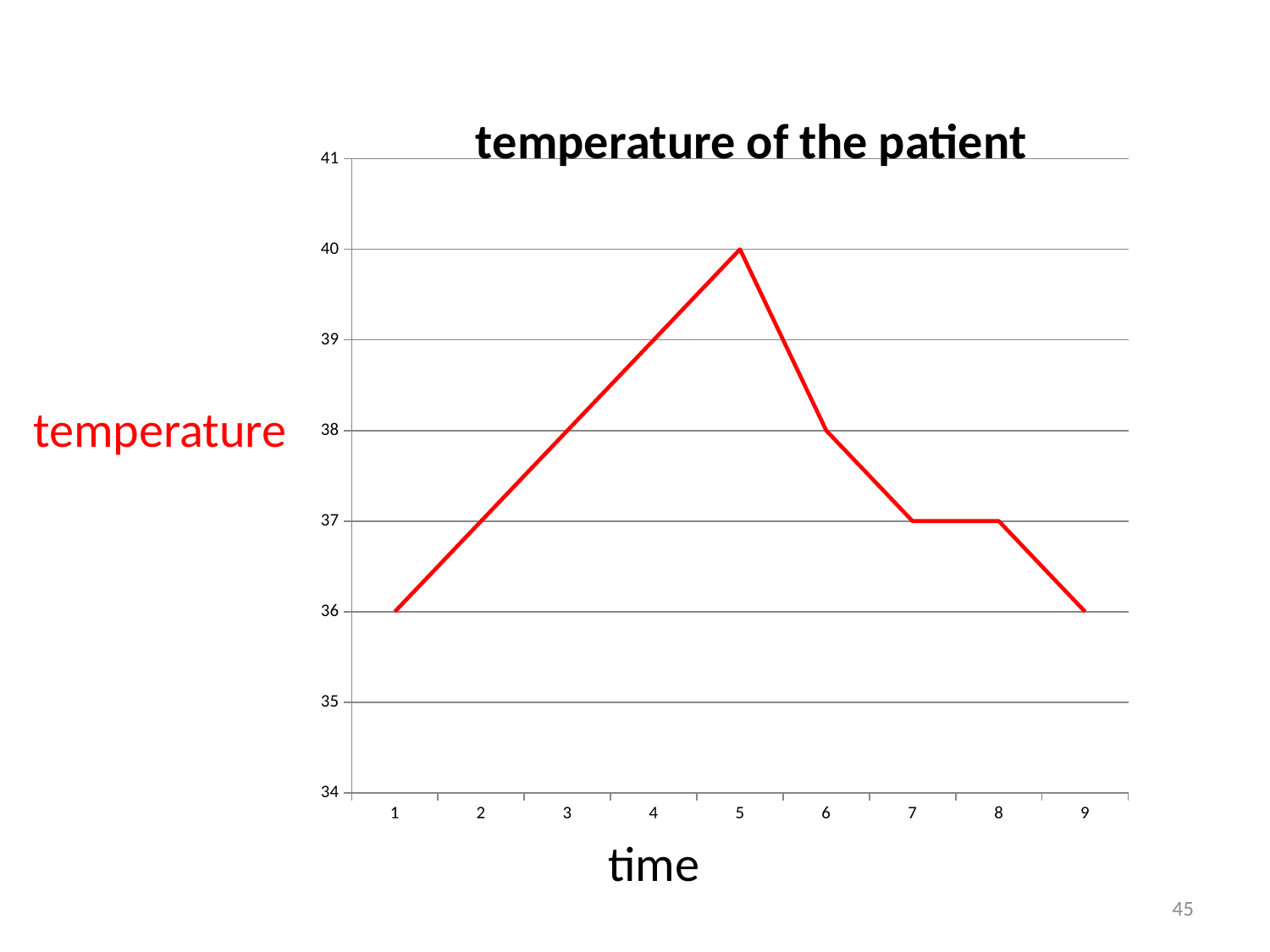
Is the temperature higher at time 6 or at time 8? time 6 What kind of chart is shown on the slide? line chart What is the temperature at time 1? 36 What is the label of the x axis? time At which time is the temperature of the patient highest? 5 What is the title of the chart? temperature of the patient What is the temperature at time 5? 40 How many time points are plotted on the chart? 9 What is the temperature at time 6? 38 What is the difference between the temperature at time 5 and the temperature at time 9? 4 Does the temperature rise or fall between time 1 and time 5? rise What is the temperature at time 7? 37